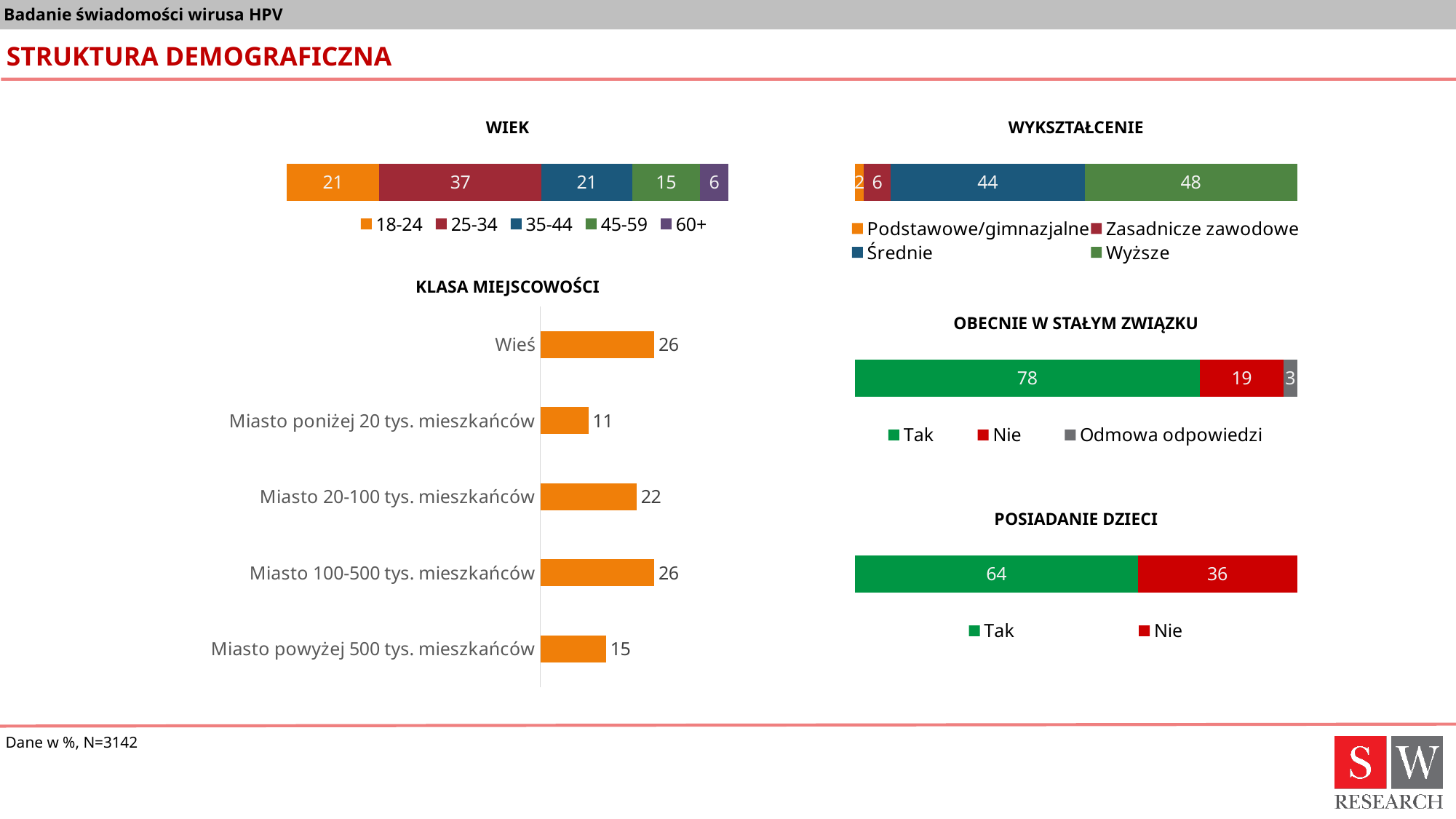
In the OBECNIE W STAŁYM ZWIĄZKU chart, what is the value for Nie? 19 In the POSIADANIE DZIECI chart, what is the difference between Tak and Nie? 28 In the OBECNIE W STAŁYM ZWIĄZKU chart, what is the total of the stacked bar? 100 In the WYKSZTAŁCENIE chart, what is the value for Wyższe? 48 In the KLASA MIEJSCOWOŚCI chart, how many categories are shown? 5 In the KLASA MIEJSCOWOŚCI chart, what is the value for Miasto poniżej 20 tys. mieszkańców? 11 In the KLASA MIEJSCOWOŚCI chart, which is larger: Miasto 20-100 tys. mieszkańców or Miasto powyżej 500 tys. mieszkańców? Miasto 20-100 tys. mieszkańców What kind of chart is the KLASA MIEJSCOWOŚCI chart? Bar chart In the WIEK chart, what is the value for the 25-34 age group? 37 In the WIEK chart, how many age groups does the legend list? 5 In the WYKSZTAŁCENIE chart, what is the difference between Średnie and Zasadnicze zawodowe? 38 In the WIEK chart, which age group has the lowest value? 60+